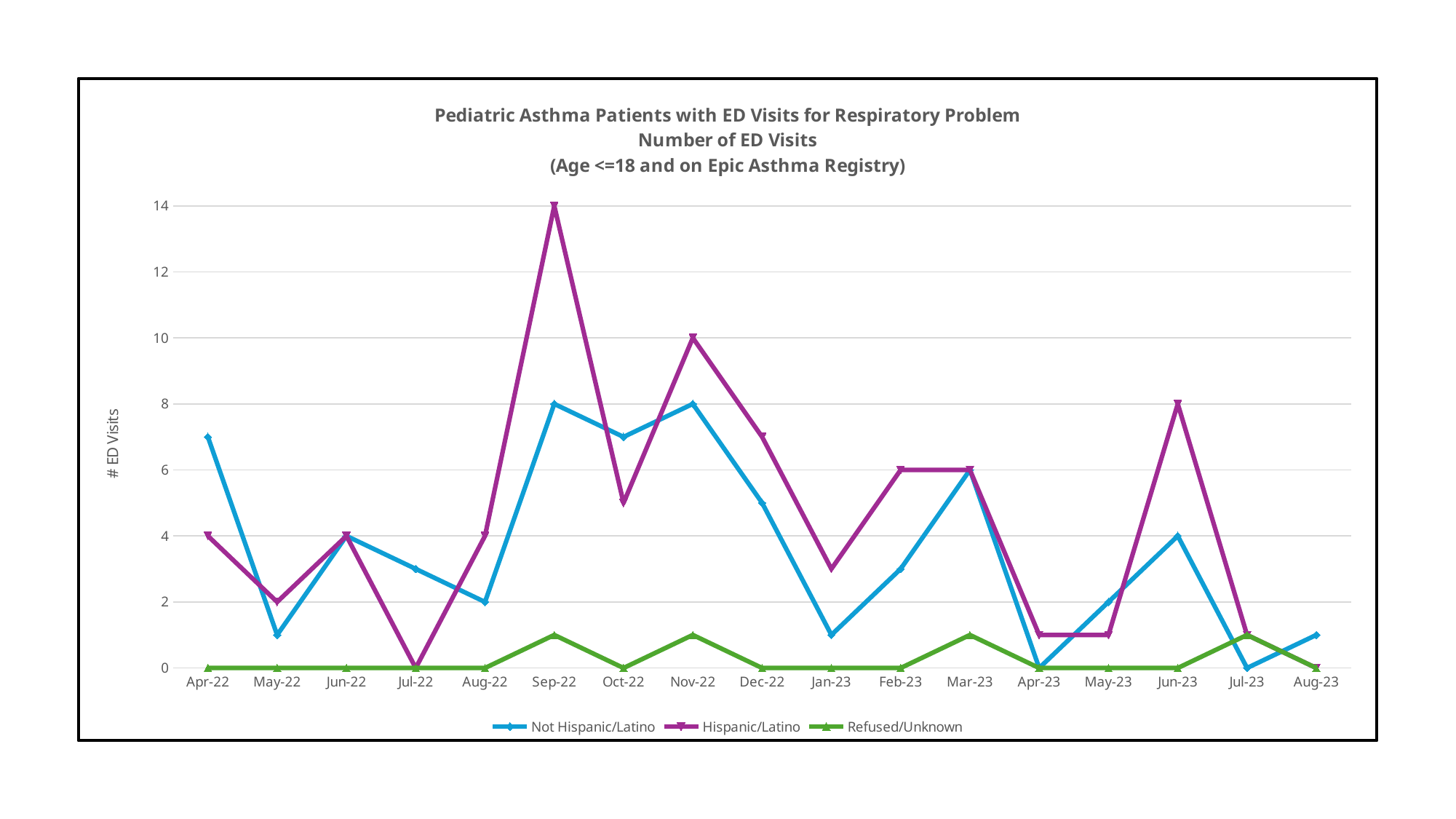
What is the number of ED visits for Hispanic/Latino patients in Jun-23? 8 What is the label of the y axis? # ED Visits What is the difference between the Hispanic/Latino and Not Hispanic/Latino values in Sep-22? 6 How many series does the legend list? 3 What is the number of ED visits for Hispanic/Latino patients in Nov-22? 10 How many months are plotted along the x axis? 17 What is the number of ED visits for Not Hispanic/Latino patients in Sep-22? 8 In which month does the Hispanic/Latino series reach its highest value? Sep-22 In Nov-22, which series has more ED visits, Hispanic/Latino or Not Hispanic/Latino? Hispanic/Latino Is the value for Not Hispanic/Latino in Apr-22 greater or less than 6? greater What is the number of ED visits for Hispanic/Latino patients in Sep-22? 14 What kind of chart is shown on the slide? line chart